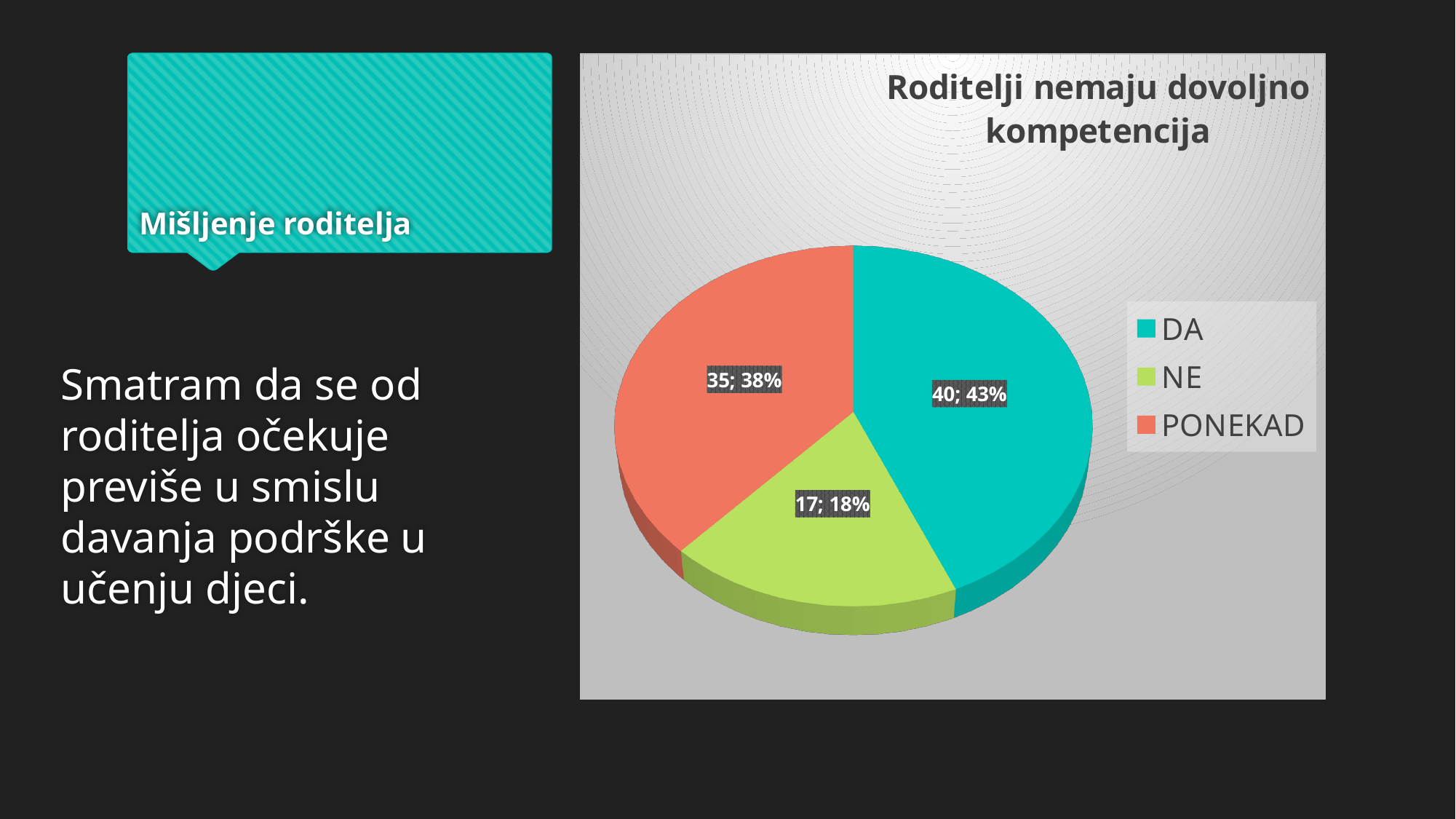
Which category has the smallest slice? NE What is the count for the DA slice? 40 What is the count for the NE slice? 17 What type of chart is shown on the slide? pie chart How many entries does the legend list? 3 Which category has the largest slice? DA How many slices does the pie chart have? 3 What percentage share does the DA slice have? 43% What is the difference between the counts for DA and NE? 23 What is the title of the chart? Roditelji nemaju dovoljno kompetencija What is the count for the PONEKAD slice? 35 What percentage share does the NE slice have? 18%